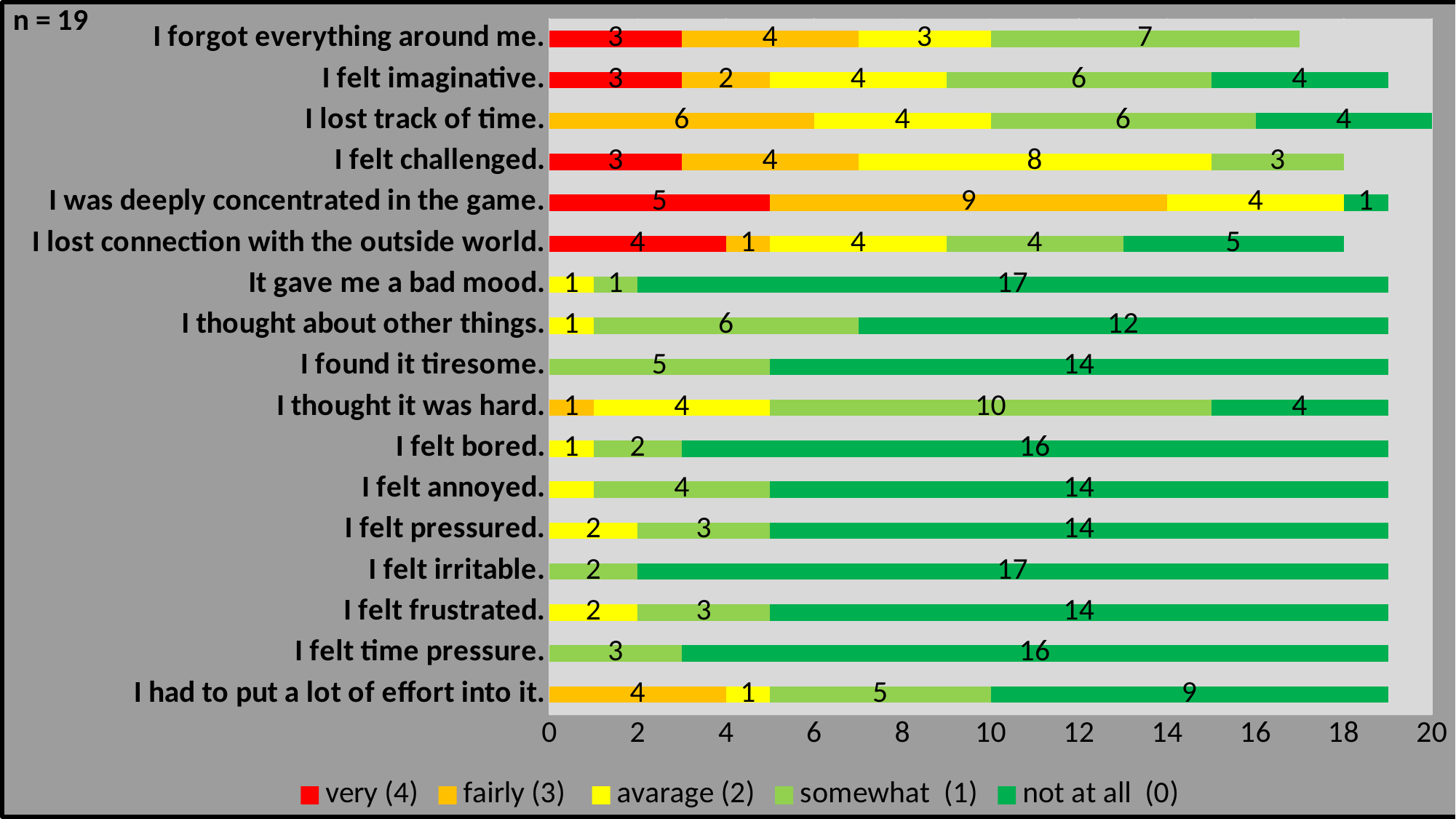
What is the 'not at all (0)' value for 'It gave me a bad mood.'? 17 Which legend entry is shown in red? very (4) Which statement has the highest 'fairly (3)' value? I was deeply concentrated in the game. What is the difference between the 'not at all (0)' values for 'I felt bored.' and 'I had to put a lot of effort into it.'? 7 How many statements (categories) are plotted on the chart? 17 What is the total of the stacked bar for 'I felt challenged.'? 18 What is the total of the stacked bar for 'I lost track of time.'? 20 What is the 'somewhat (1)' value for 'I thought it was hard.'? 10 What kind of chart is shown on the slide? stacked bar chart What is the 'fairly (3)' value for 'I was deeply concentrated in the game.'? 9 Which has the larger 'very (4)' value: 'I was deeply concentrated in the game.' or 'I lost connection with the outside world.'? I was deeply concentrated in the game. How many series does the legend list? 5